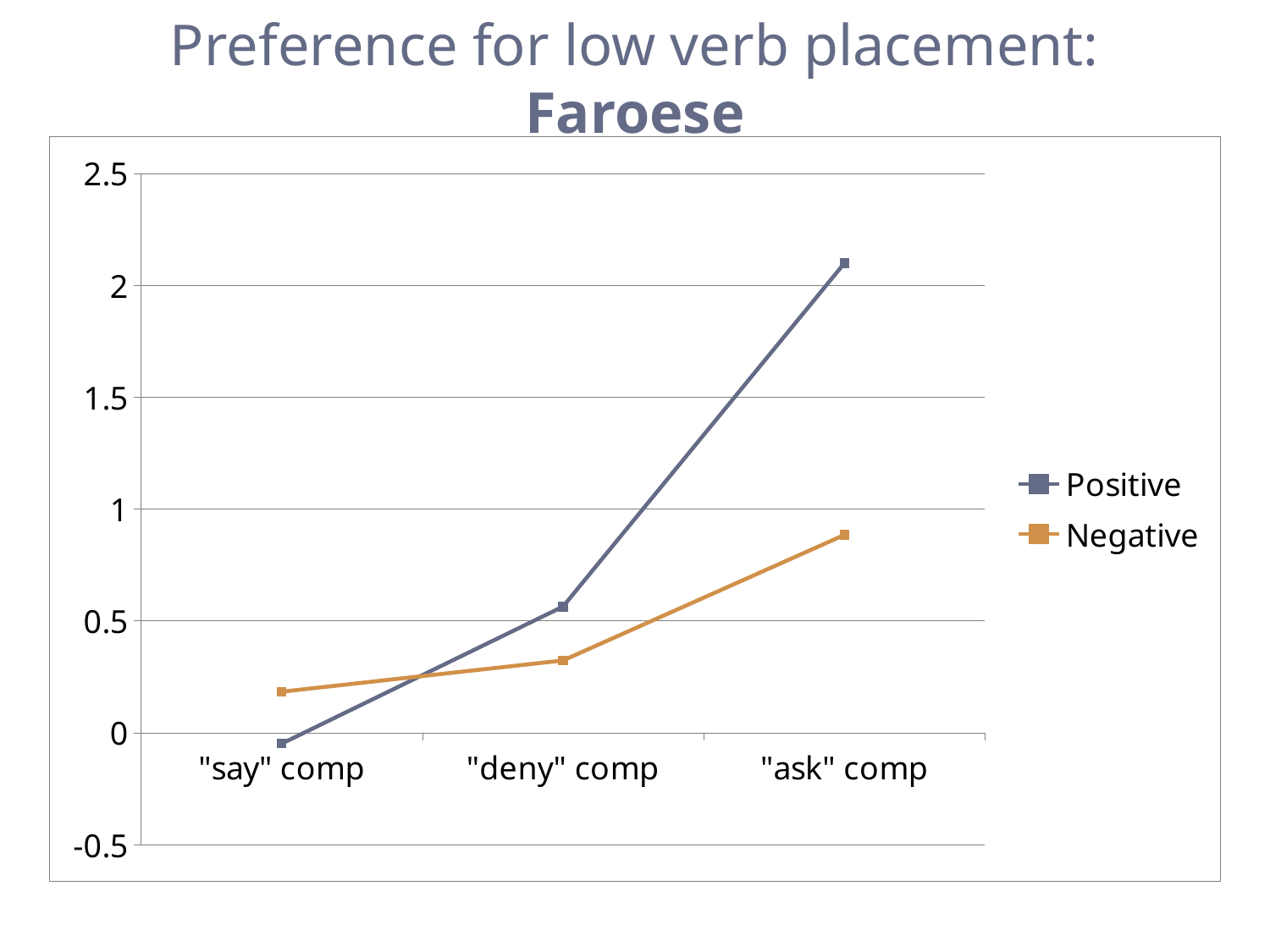
What kind of chart is shown on the slide? line chart Do the values for the Positive series rise or fall from "say" comp to "ask" comp? rise How many series does the legend list? 2 Is the value for the Negative series at "ask" comp greater or less than 1? less For which category is the Positive series highest? "ask" comp Do the values for the Negative series rise or fall from "say" comp to "ask" comp? rise Is the value for the Positive series at "ask" comp greater or less than 1.5? greater What is the title of the chart? Preference for low verb placement: Faroese Which series are listed in the legend? Positive and Negative How many categories are shown on the x axis? 3 For which category is the Positive series lowest? "say" comp At "ask" comp, which series has the larger value, Positive or Negative? Positive